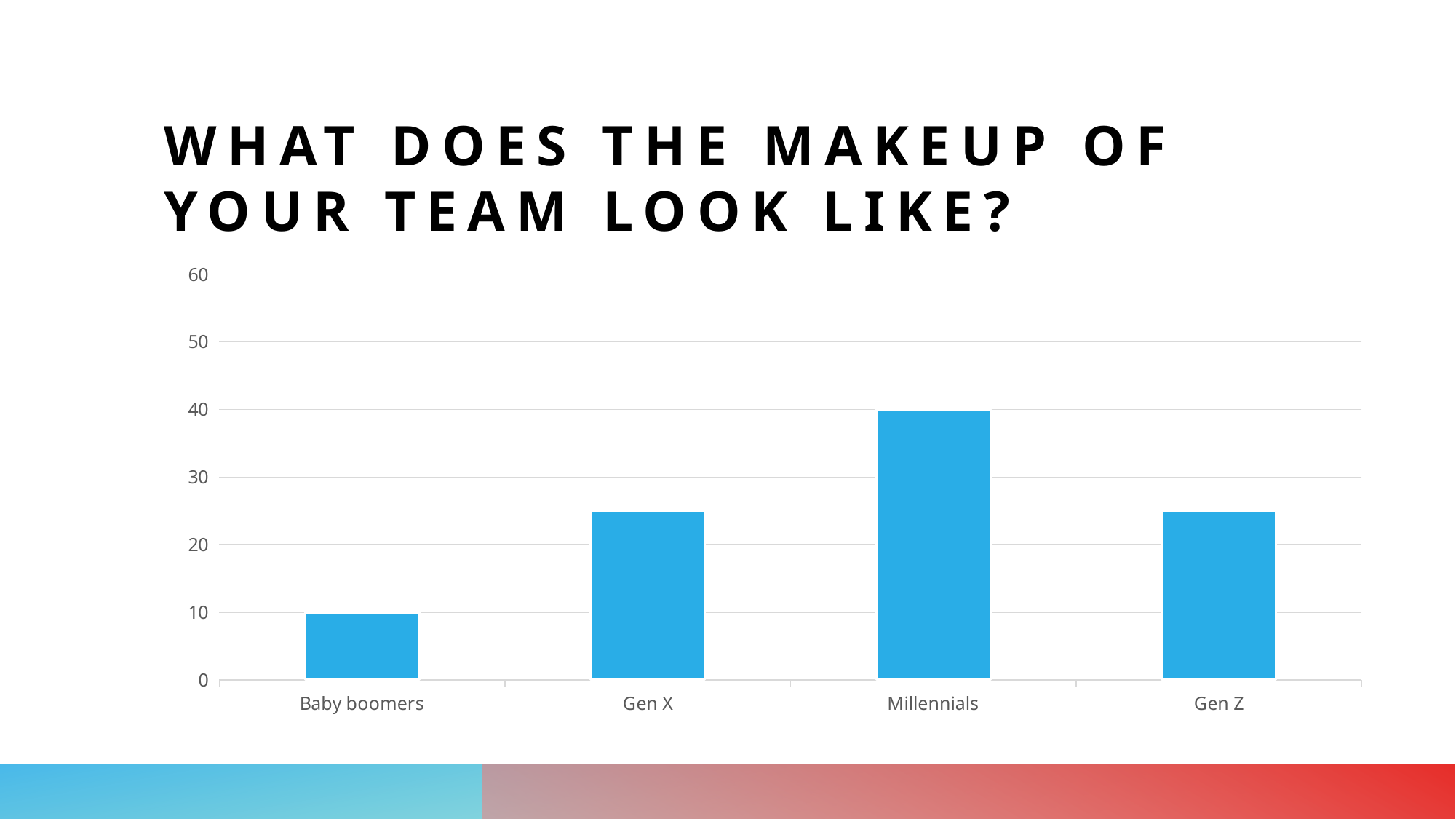
Is the value for Gen X greater or less than 20? greater Which category has the highest bar in the chart? Millennials Which is larger, the value for Gen X or the value for Baby boomers? Gen X What is the value for Baby boomers in the chart? 10 How many categories are shown on the x axis of the chart? 4 What is the value for Millennials in the chart? 40 What is the title of the slide containing the chart? What does the makeup of your team look like? What is the difference between the values for Millennials and Baby boomers? 30 Is the value for Gen Z greater or less than 30? less What kind of chart is shown on the slide? Bar chart Which is larger, the value for Millennials or the value for Gen Z? Millennials Which category has the lowest bar in the chart? Baby boomers